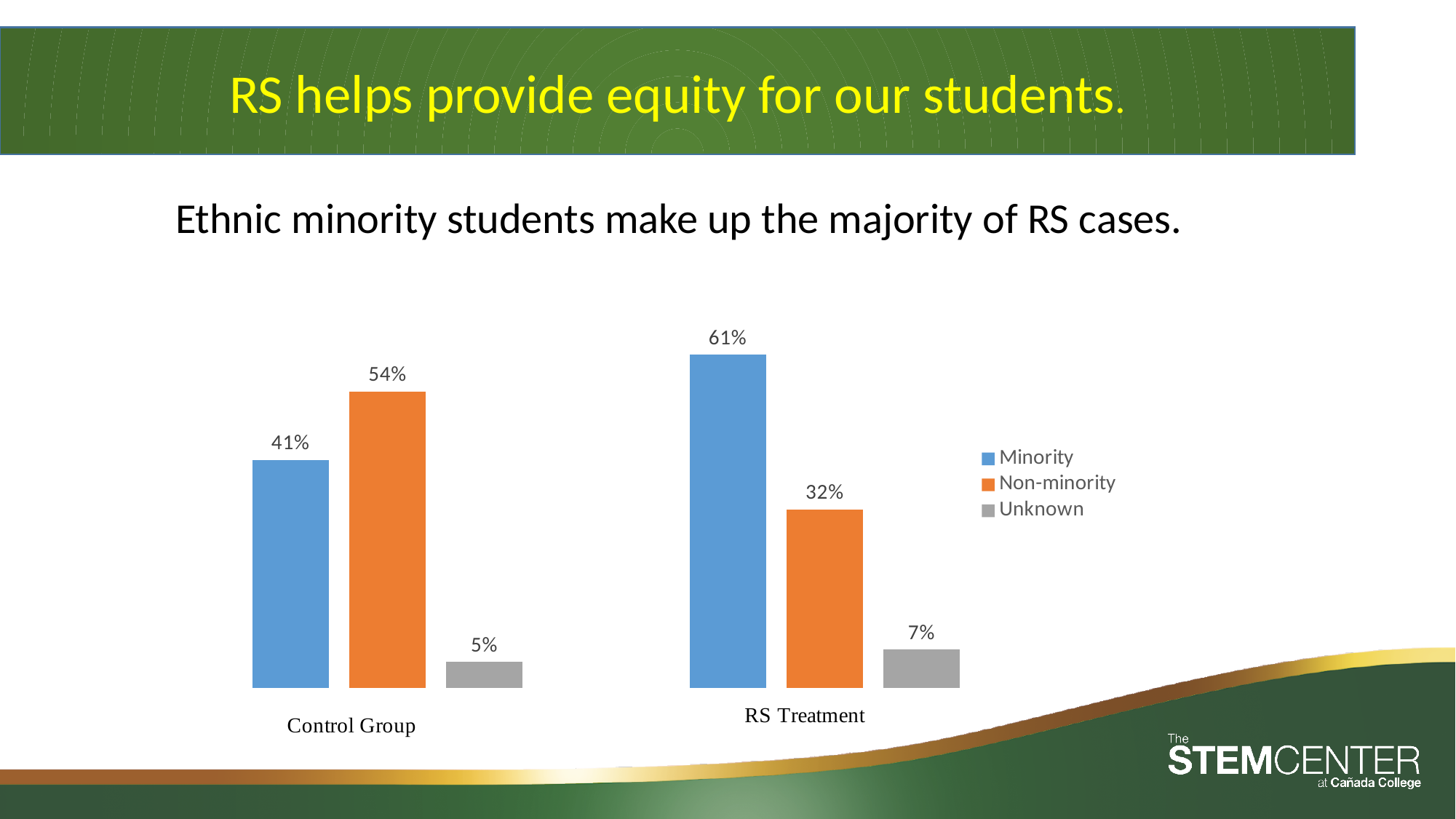
Which is larger in the Control Group, Minority or Non-minority? Non-minority What is the difference between Non-minority and Minority in the Control Group? 13% Which series has the lowest value in the Control Group? Unknown How many categories are shown on the x axis? 2 How many series does the legend list? 3 What is the value for Non-minority in the RS Treatment group? 32% What colour represents the Unknown series? Gray Which series has the highest value in the RS Treatment group? Minority What is the difference between the Minority values for RS Treatment and Control Group? 20% What is the value for Minority in the Control Group? 41% What kind of chart is shown on the slide? Bar chart What is the value for Unknown in the Control Group? 5%